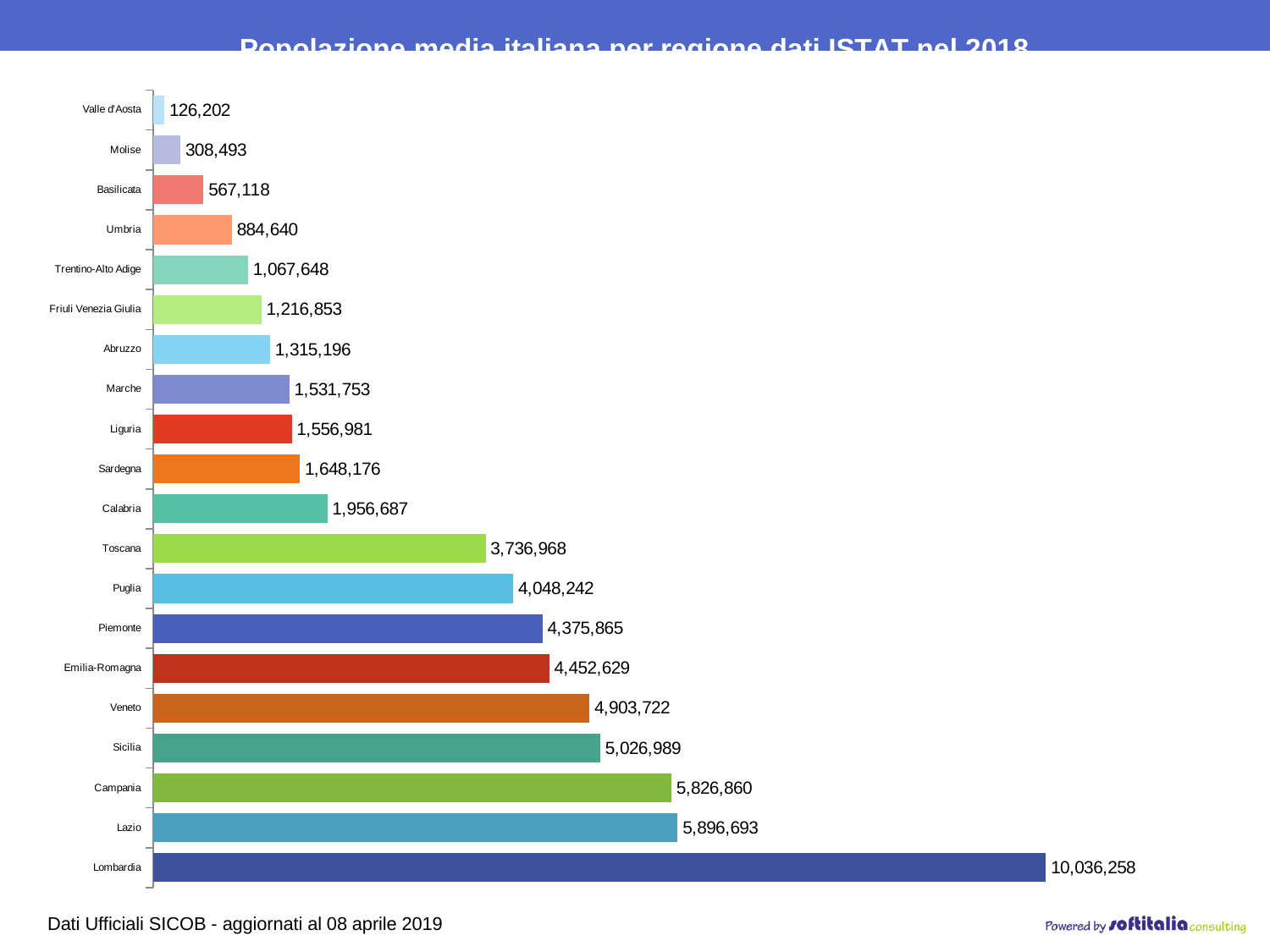
What is the difference between the values for Veneto and Emilia-Romagna? 451,093 What is the value for Toscana? 3,736,968 Which region has the lowest value? Valle d'Aosta Which has a larger value, Sicilia or Veneto? Sicilia What is the value for Lombardia? 10,036,258 How many regions are shown in the chart? 20 What kind of chart is shown on the slide? Bar chart What is the difference between the values for Molise and Valle d'Aosta? 182,291 Which region has the highest value? Lombardia What is the difference between the values for Lombardia and Lazio? 4,139,565 Which has a larger value, Puglia or Toscana? Puglia What is the value for Trentino-Alto Adige? 1,067,648